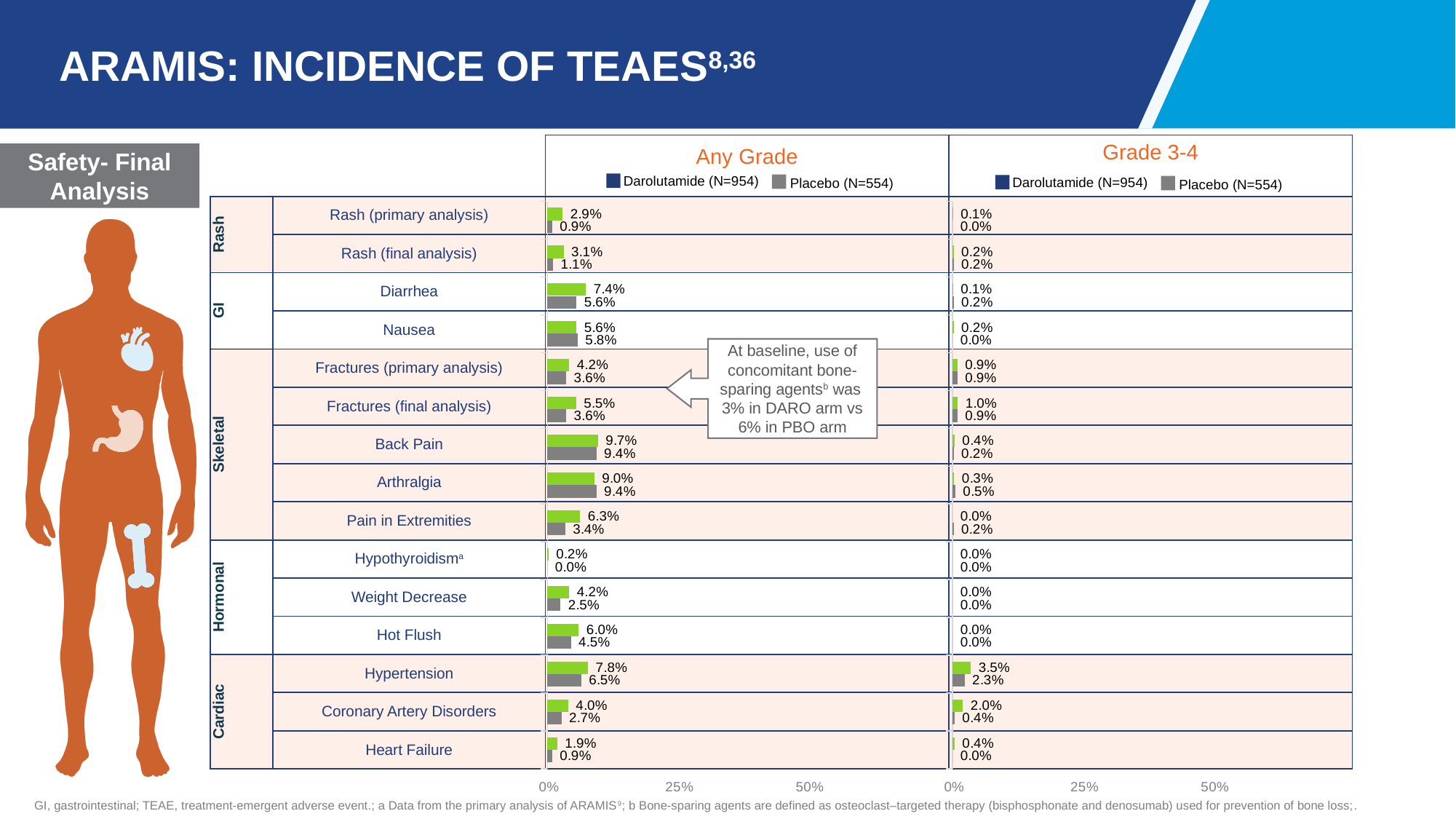
In the Any Grade chart, is the Darolutamide value for Nausea larger or smaller than the Placebo value? smaller In the Grade 3-4 chart, which adverse event has the highest Darolutamide value? Hypertension In the Any Grade chart, what is the Darolutamide value for Back Pain? 9.7% How many series does the legend of the Any Grade chart list? 2 In the Grade 3-4 chart, what is the Darolutamide value for Hypertension? 3.5% In the Grade 3-4 chart, what is the Placebo value for Coronary Artery Disorders? 0.4% In the Any Grade chart, which adverse event has the highest Darolutamide value? Back Pain In the Any Grade chart, is the Darolutamide value for Diarrhea greater or less than 25%? less In the Any Grade chart, what is the Placebo value for Hypertension? 6.5% In the Any Grade chart, which adverse event has the lowest Darolutamide value? Hypothyroidism What kind of chart is used to show the Any Grade incidence values? Bar chart In the Any Grade chart, what is the difference between the Darolutamide and Placebo values for Pain in Extremities? 2.9%